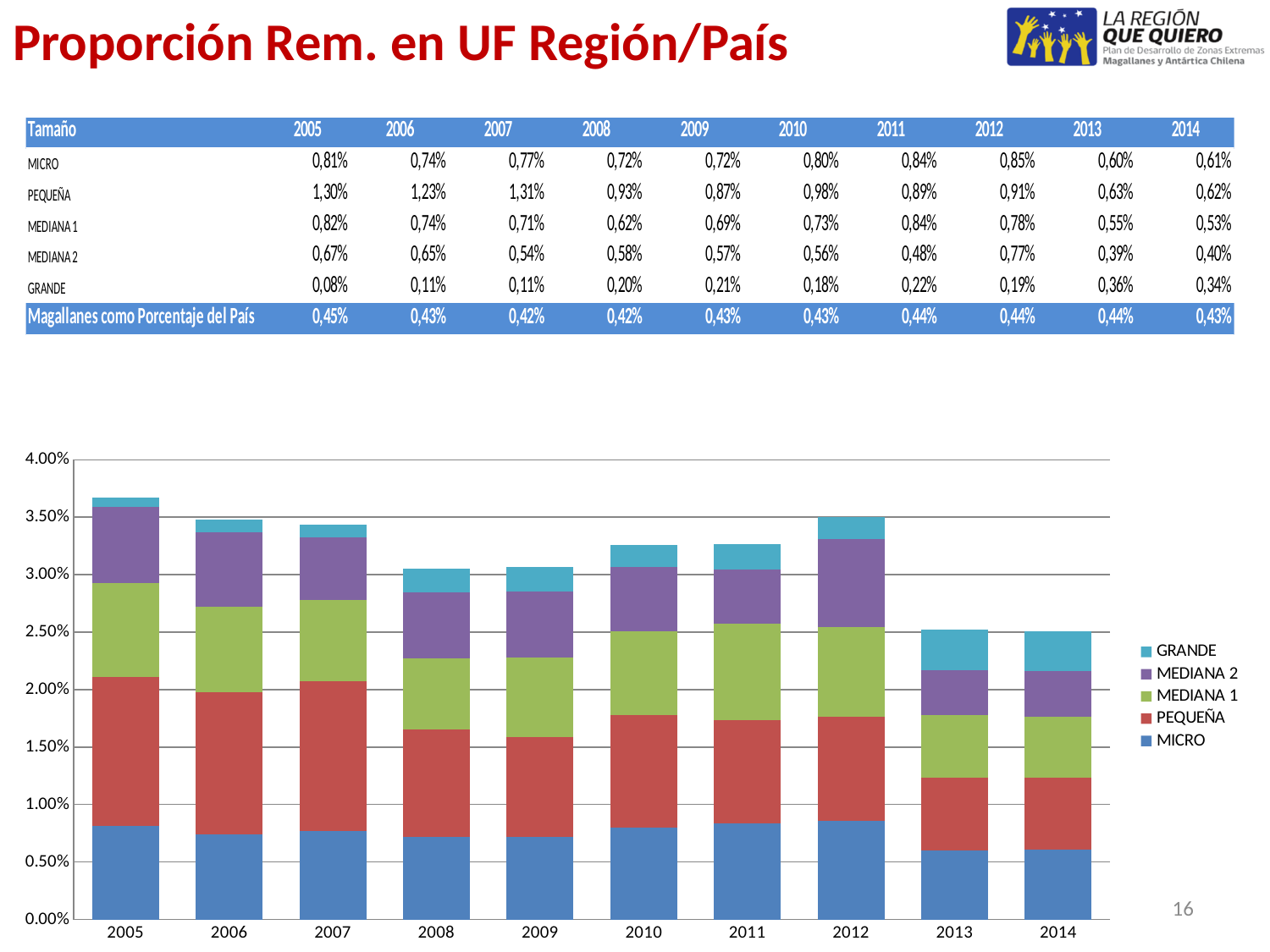
How many years are shown along the x axis of the chart? 10 What is the total of the stacked bar for 2014? 2,50% Which year has the tallest stacked bar in the chart? 2005 Is the total stacked bar for 2013 greater or less than 3.00%? less How many series does the chart legend list? 5 Which series is listed first (at the top) in the chart legend? GRANDE Which year has the larger MEDIANA 2 value, 2012 or 2013? 2012 What kind of chart is shown on the slide? stacked bar chart What is the value for MICRO in 2005? 0,81% What is the difference between the PEQUEÑA value in 2005 and in 2014? 0,68% What is the value for GRANDE in 2014? 0,34% Is the total stacked bar for 2005 greater or less than 3.50%? greater